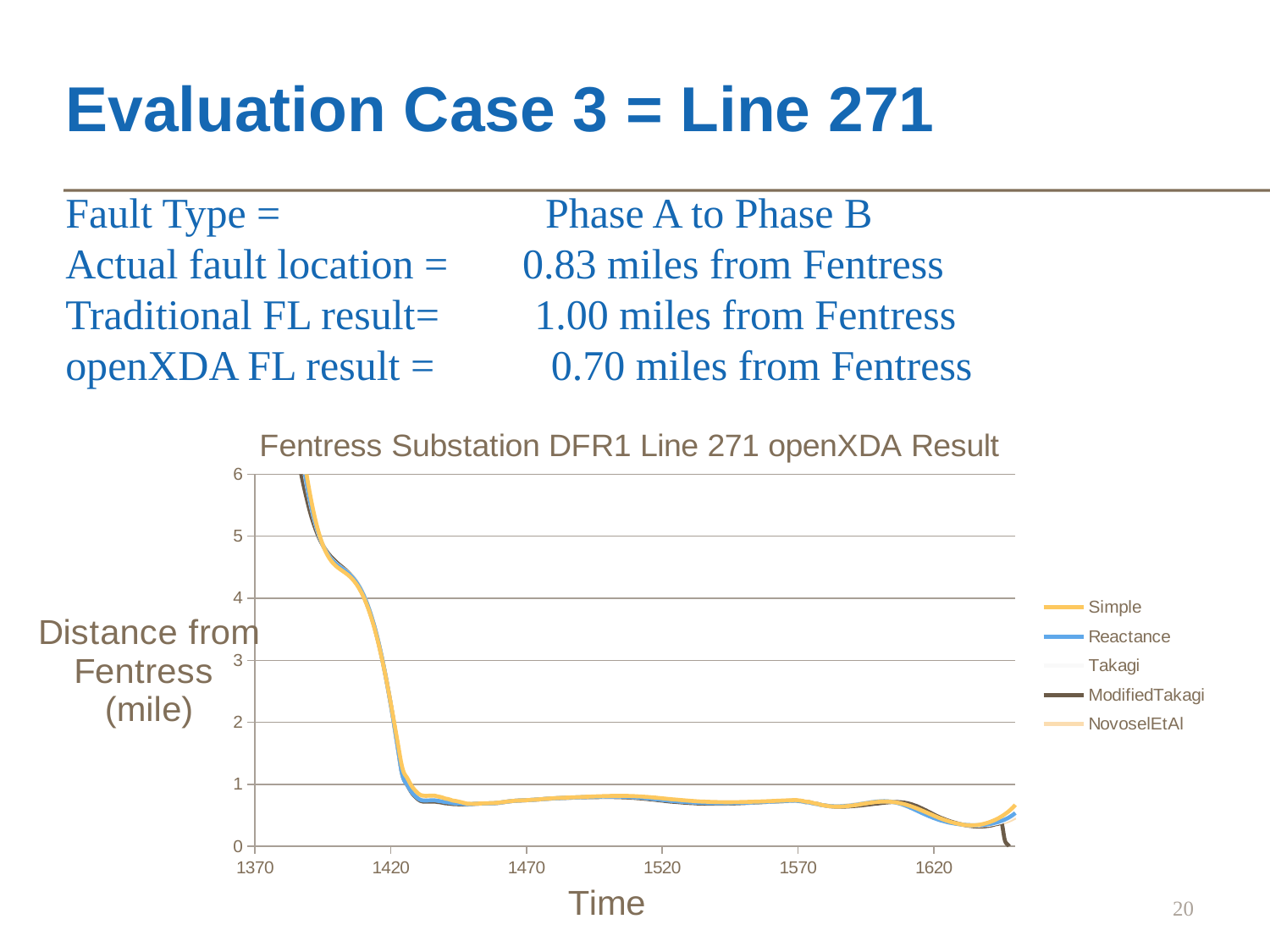
What is the label of the x axis of the chart? Time Is the value of the Reactance series at time 1570 greater or less than 1? less What is the lowest time value shown on the x axis of the chart? 1370 How many tick labels are shown on the x axis of the chart? 6 How many series does the legend of the chart list? 5 Is the value of the Simple series at time 1520 greater or less than 1? less Do the plotted values rise or fall along the x axis between 1370 and 1470? fall What kind of chart is shown on the slide? line chart Is the value of the Simple series at time 1470 greater or less than 2? less What is the highest value shown on the y axis of the chart? 6 What is the title of the chart? Fentress Substation DFR1 Line 271 openXDA Result Which series is listed first in the chart legend? Simple